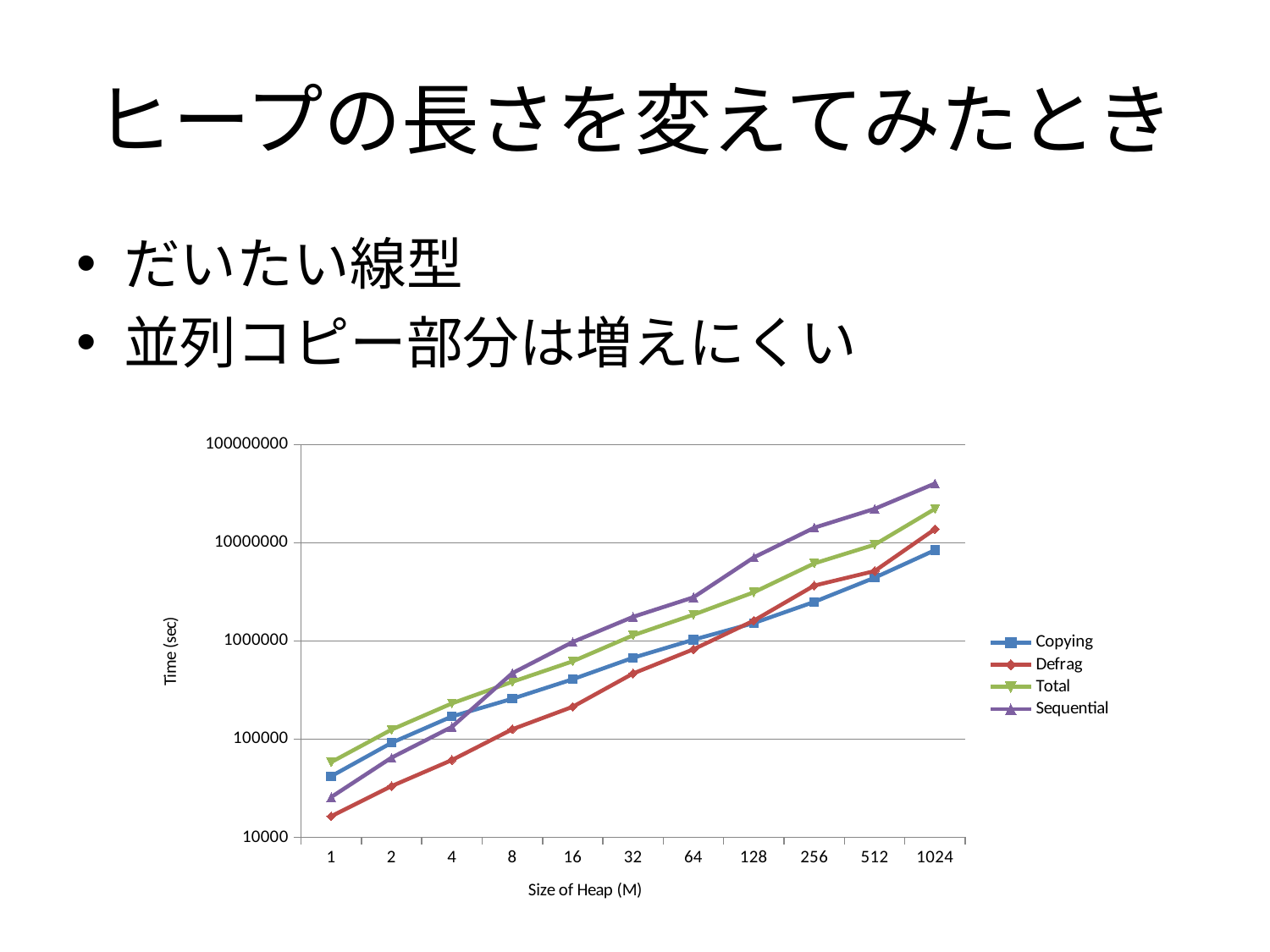
At heap size 1024, which is larger: Sequential or Copying? Sequential Is the value for Sequential at heap size 1024 greater or less than 10000000? greater How many series does the legend list? 4 How many heap sizes are plotted along the x axis? 11 Which series has the highest value at heap size 1? Total Do the values for the Sequential series rise or fall as the heap size increases? rise Which series has the lowest value at heap size 1? Defrag What kind of chart is shown on the slide? line chart Which series has the lowest value at heap size 1024? Copying Is the value for Copying at heap size 1 greater or less than 100000? less What is the label of the x axis? Size of Heap (M) Which series has the highest value at heap size 1024? Sequential